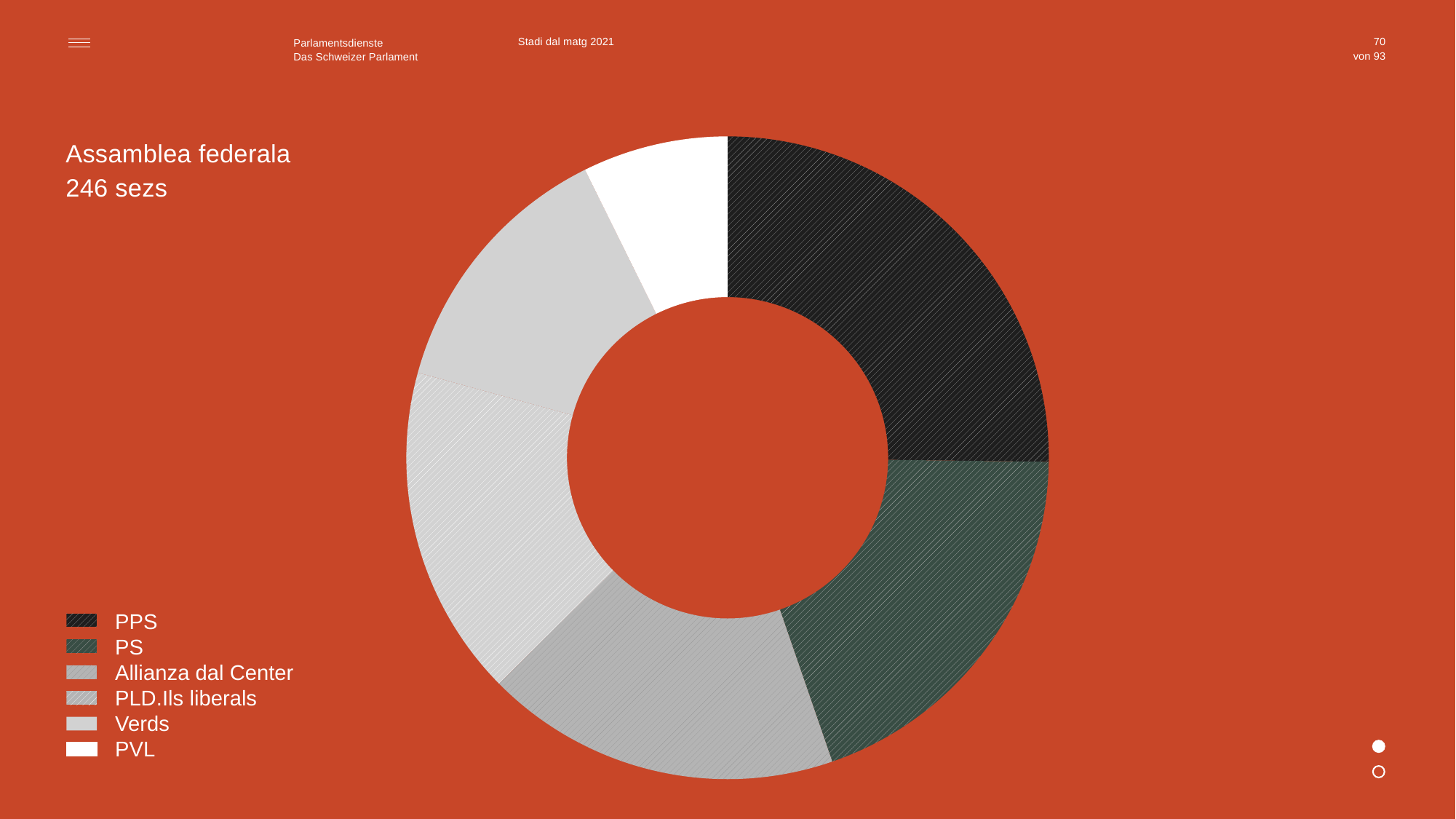
What is the title of the chart? Assamblea federala Which party has the largest share of seats in the chart? PPS Which has the larger share, Verds or PVL? Verds How many seats in total does the chart represent, according to the subtitle? 246 sezs Which has the larger share, PPS or Verds? PPS How many parties (segments) does the chart show? 6 What kind of chart is shown on the slide? Pie chart (donut) Which has the larger share, PPS or PS? PPS How many entries does the legend list? 6 Which party has the smallest share of seats in the chart? PVL